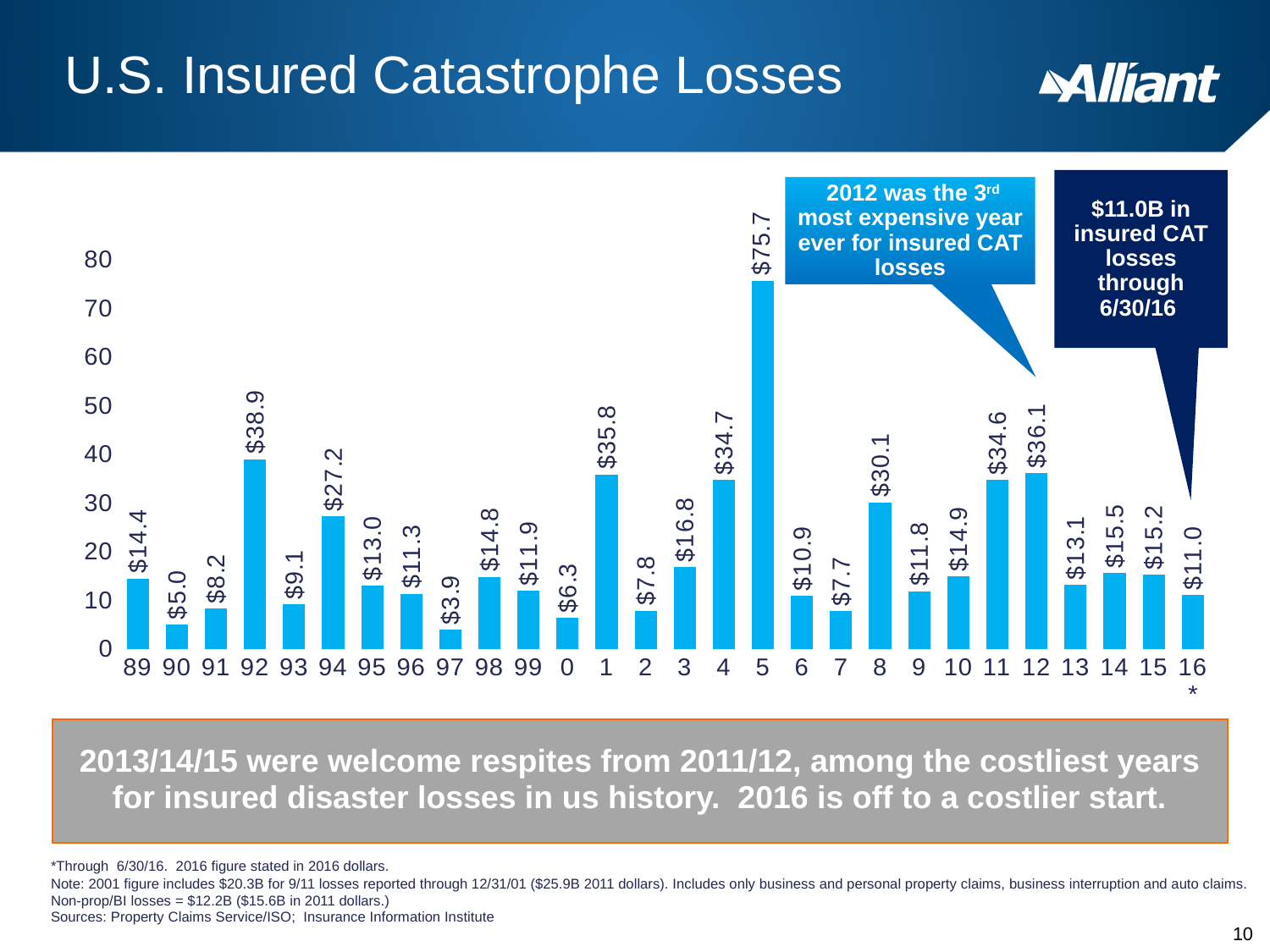
What kind of chart is shown on the slide? Bar chart Which is larger, the value for 1992 (labelled 92) or the value for 2001 (labelled 1)? 1992 (labelled 92) What is the value shown for 2005 (labelled 5) on the chart? $75.7 Is the value for 2008 (labelled 8) greater or less than 20? greater What is the value shown for 2016 (labelled 16*) on the chart? $11.0 Which year has the lowest insured catastrophe losses on the chart? 97 (1997) What is the value shown for 1992 (labelled 92) on the chart? $38.9 Which year has the highest insured catastrophe losses on the chart? 5 (2005) How many bars (years) are plotted on the chart? 28 What is the value shown for 2012 (labelled 12) on the chart? $36.1 What is the difference between the values for 1992 (labelled 92) and 1994 (labelled 94)? $11.7 What is the difference between the values for 2012 (labelled 12) and 2011 (labelled 11)? $1.5